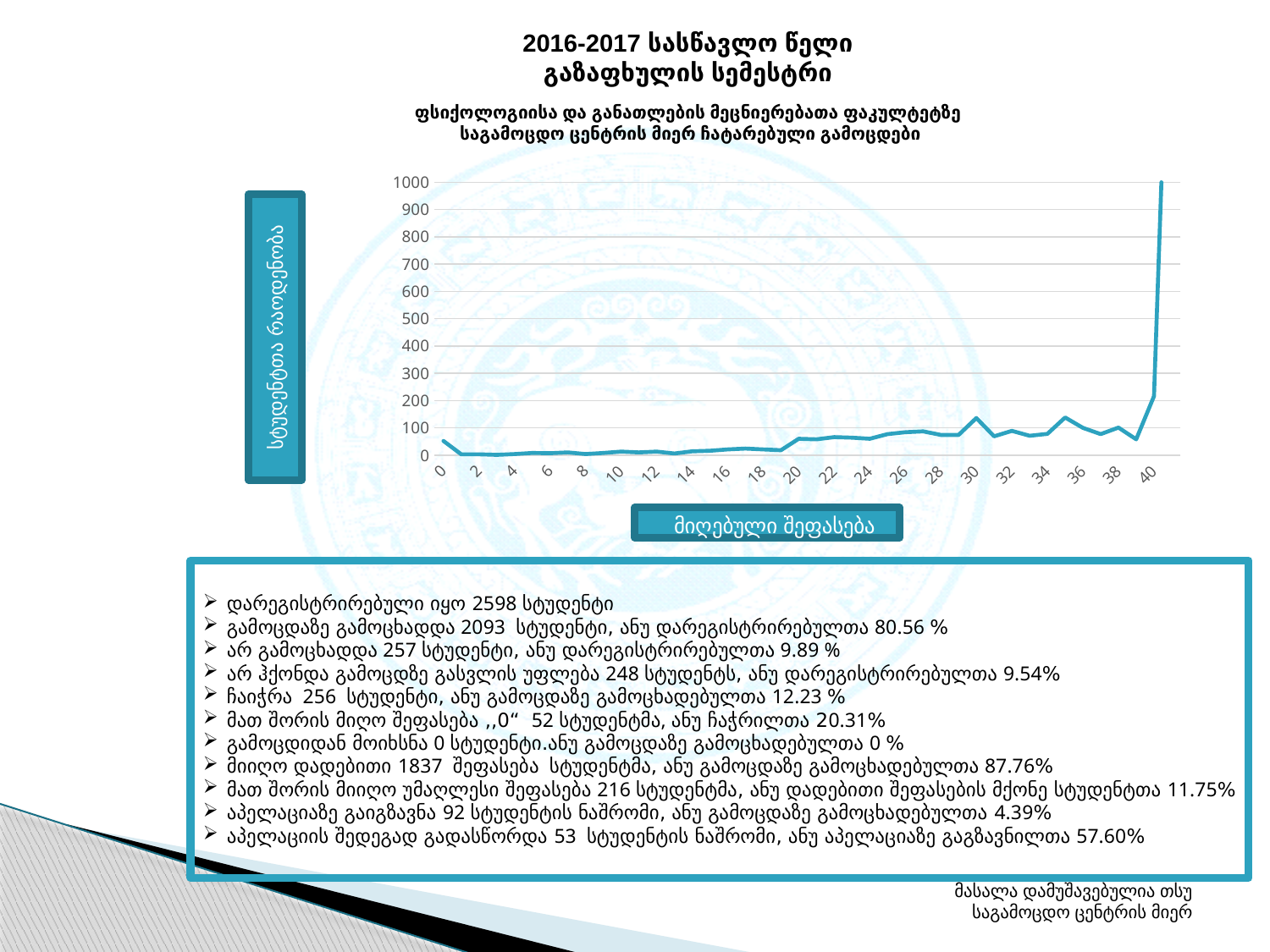
What is the highest tick value shown on the y-axis? 1000 Is the value at x = 10 greater or less than 100? less Which has the larger value, x = 40 or x = 0? 40 How many tick labels are shown on the x-axis? 21 What kind of chart is shown on the slide? line chart Is the value at x = 30 greater or less than 100? greater Overall, do the values rise or fall as the x-axis goes from 0 to 40? rise What is the label of the x-axis? მიღებული შეფასება Which has the larger value, x = 30 or x = 20? 30 Is the value at x = 20 greater or less than 200? less